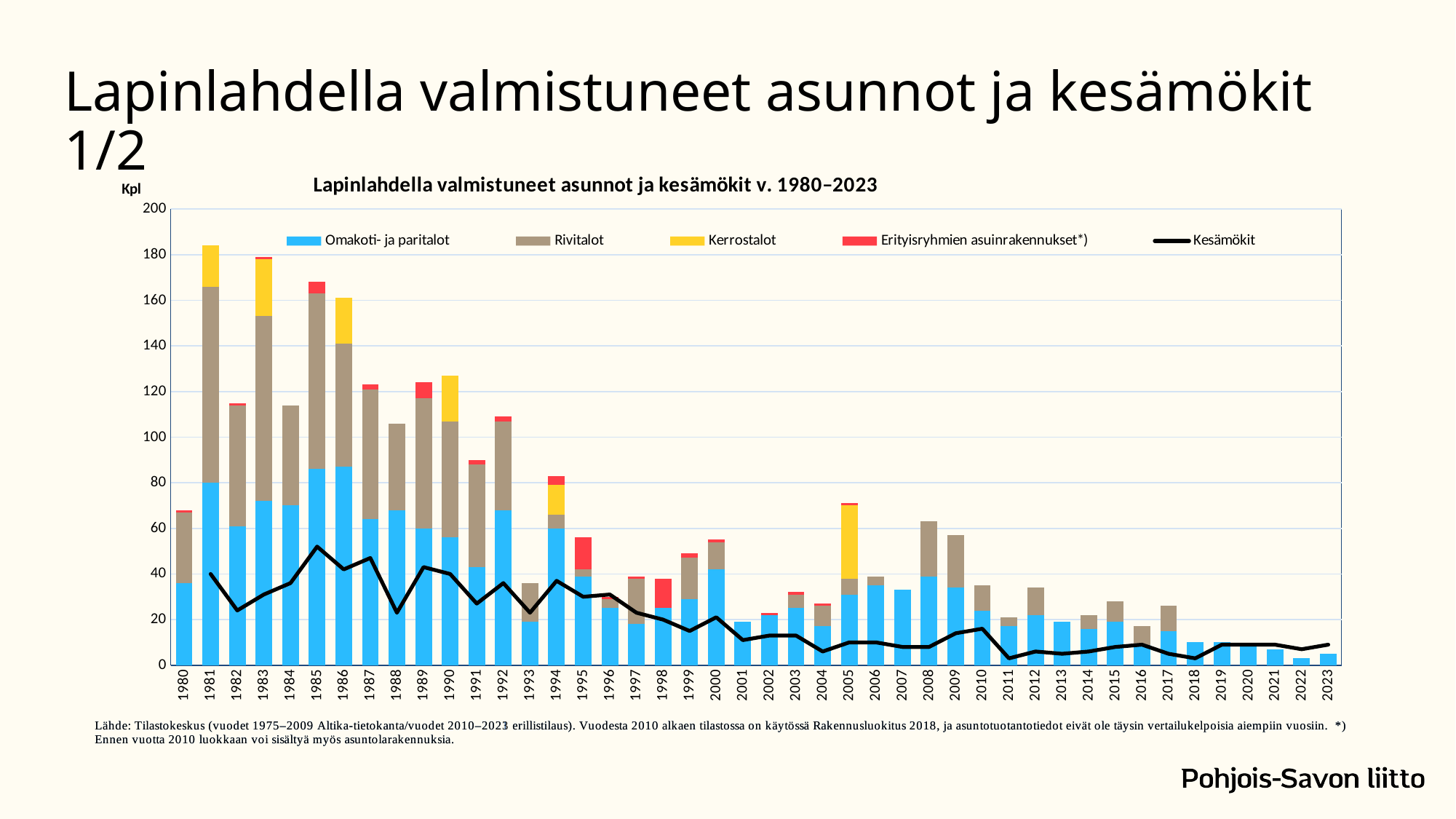
What is the title of the chart? Lapinlahdella valmistuneet asunnot ja kesämökit v. 1980–2023 Is the total stacked bar for 1985 greater or less than 160? greater Is the total stacked bar for 2023 greater or less than 20? less Which year has the tallest stacked bar in the chart? 1981 Which year has the larger total stacked bar, 1981 or 2000? 1981 Which year has the shortest stacked bar in the chart? 2022 Do the total stacked bar values generally rise or fall from 1980 to 2023? fall How many years are shown on the x axis of the chart? 44 Is the Kesämökit line value for 1985 greater or less than 40? greater Which year has the larger Omakoti- ja paritalot value, 1980 or 1986? 1986 What kind of chart is shown on the slide? Stacked bar chart with a line How many series does the chart legend list? 5